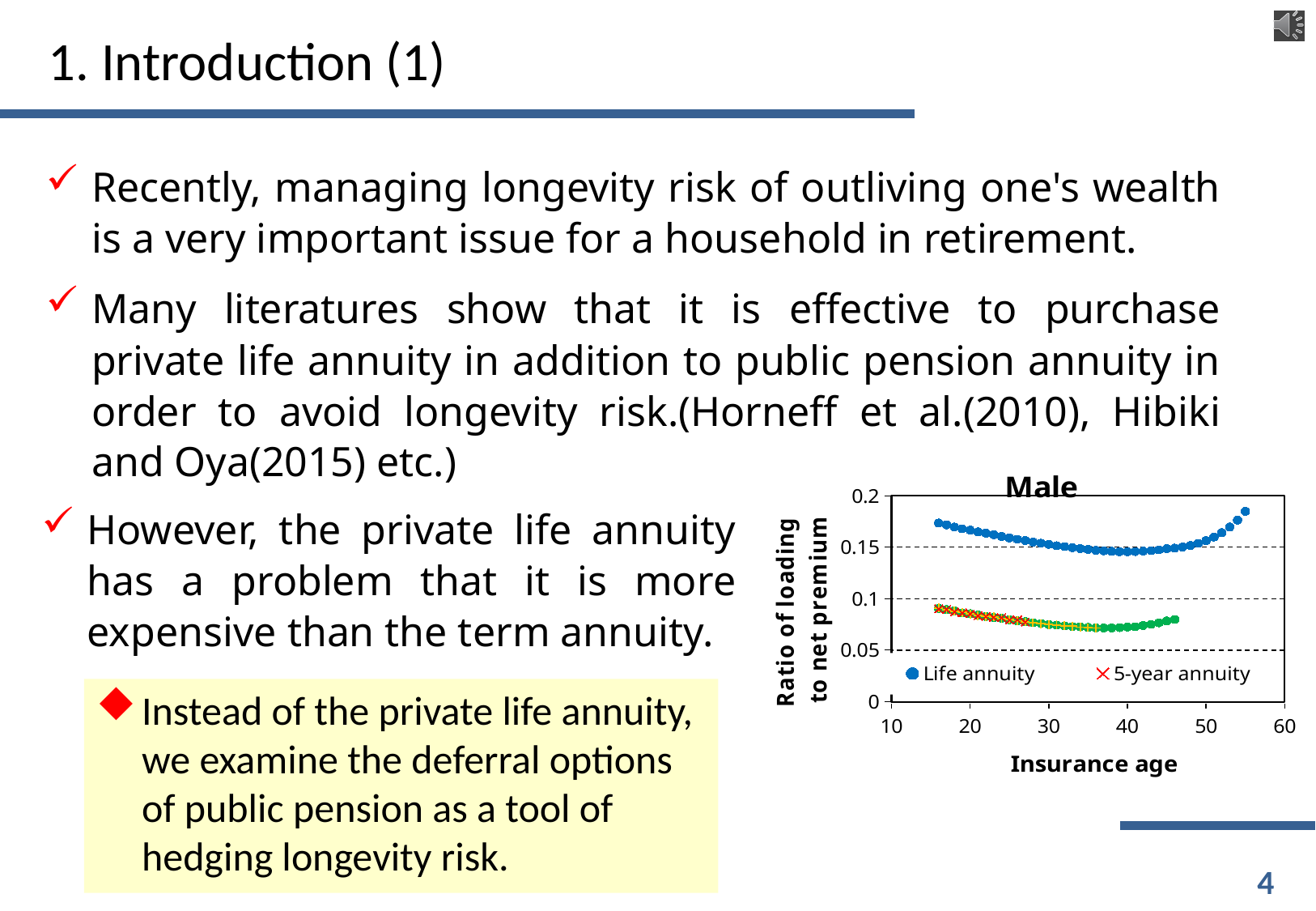
What is the title of the chart? Male Is the value for Life annuity at insurance age 20 greater or less than 0.2? less What is the label of the x axis of the chart? Insurance age How many series does the legend of the chart list? 2 Is the value for Life annuity at insurance age 20 greater or less than 0.15? greater Does the Life annuity series rise or fall as insurance age increases from 16 to 40? fall What kind of chart is shown on the slide? scatter chart Is the value for Life annuity at insurance age 55 greater or less than 0.15? greater Does the Life annuity series rise or fall as insurance age increases from 40 to 55? rise